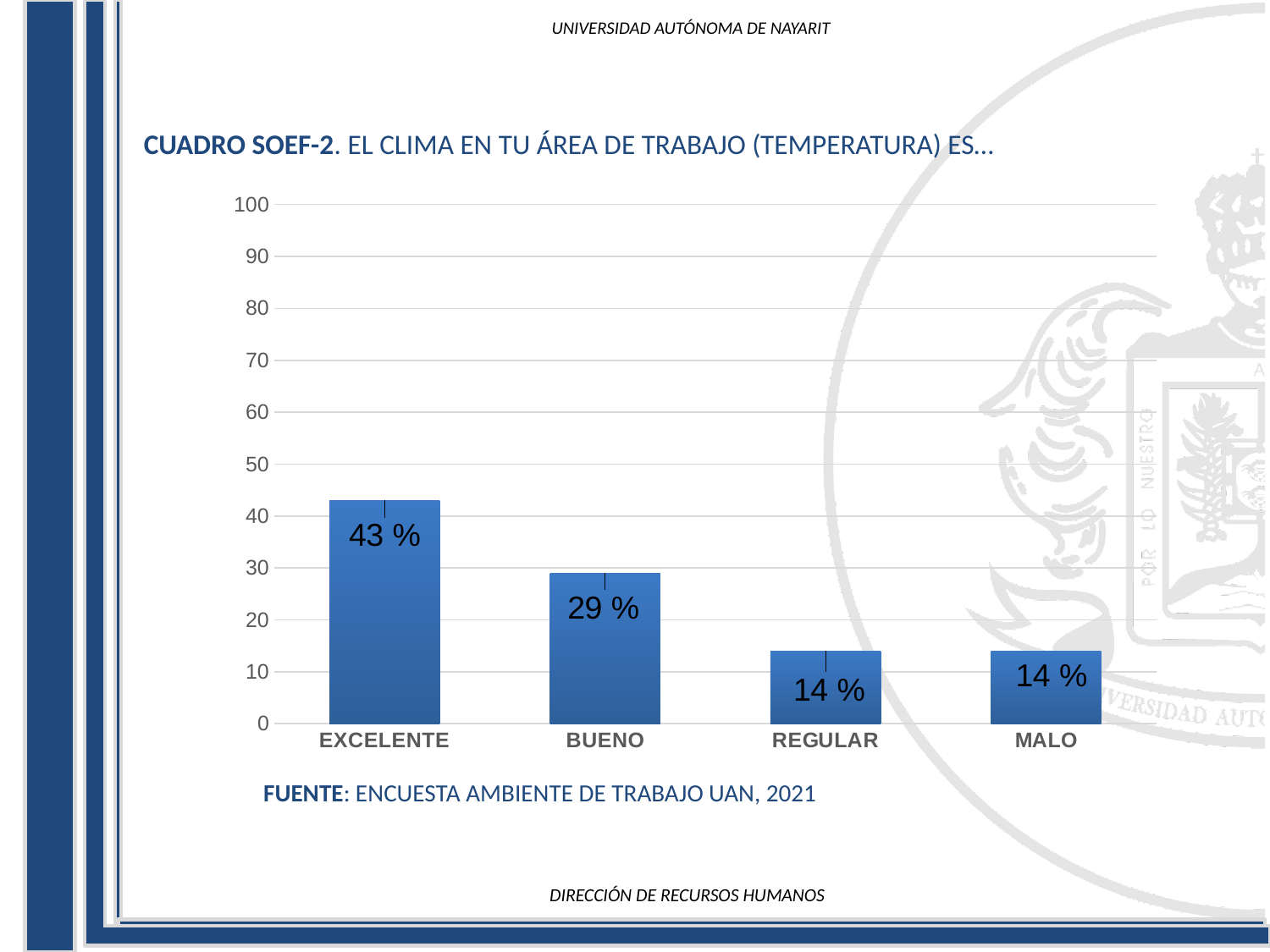
What is the difference between the values for BUENO and MALO? 15 % What is the source cited below the chart? ENCUESTA AMBIENTE DE TRABAJO UAN, 2021 What is the value for EXCELENTE? 43 % Do the values rise or fall from EXCELENTE to REGULAR along the x axis? fall What is the difference between the values for EXCELENTE and BUENO? 14 % What kind of chart is shown on the slide? bar chart Which category has the highest value? EXCELENTE How many categories are shown on the x axis? 4 What is the value for BUENO? 29 % What is the value for REGULAR? 14 % Is the value for EXCELENTE greater or less than 50? less Which is larger, the value for BUENO or the value for REGULAR? BUENO